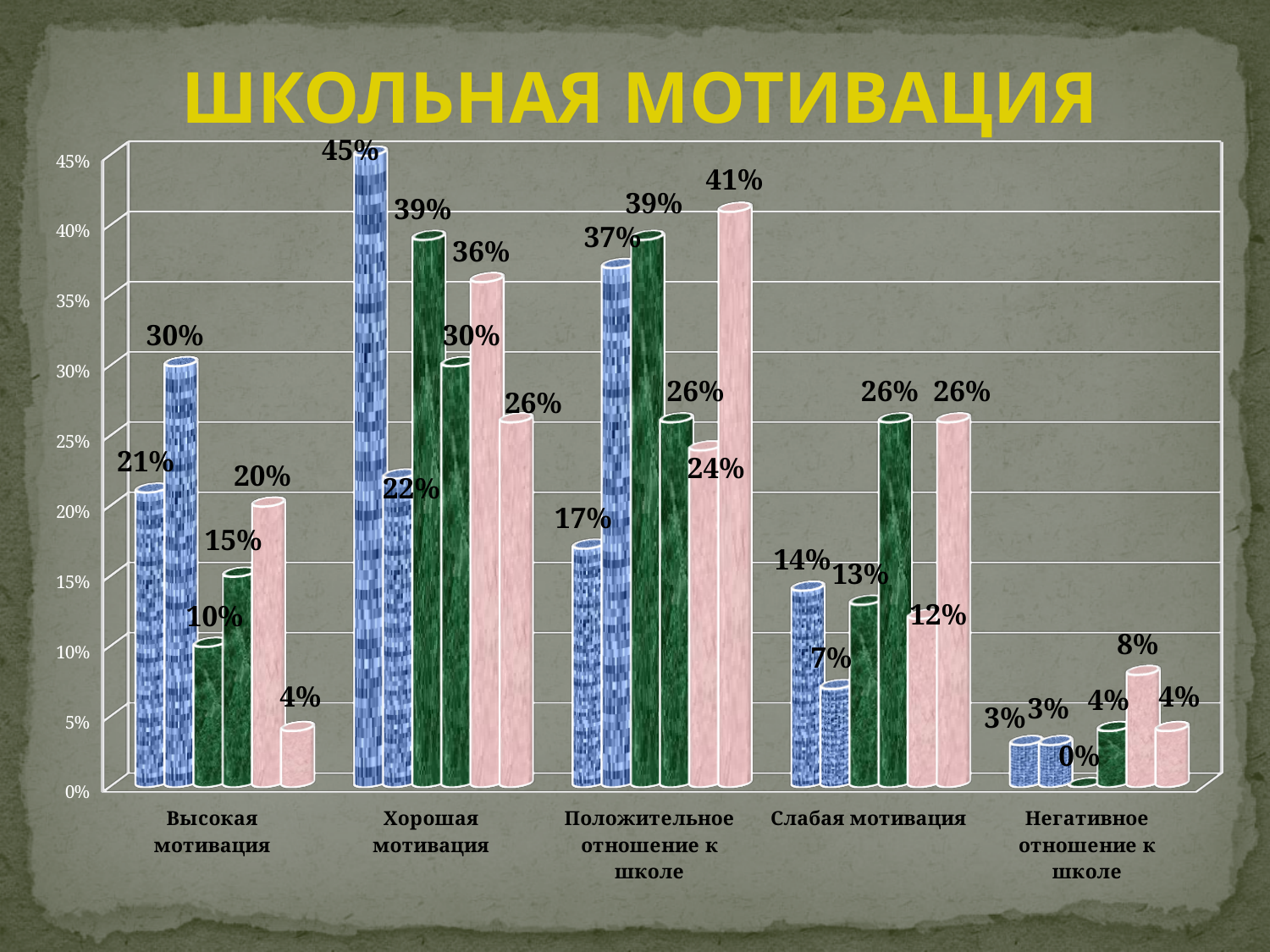
What is the highest value labelled anywhere on the chart? 45% What is the value of the tallest bar in the 'Негативное отношение к школе' group? 8% What is the difference between the tallest bar in 'Хорошая мотивация' (45%) and the tallest bar in 'Положительное отношение к школе' (41%)? 4% What is the lowest value labelled anywhere on the chart? 0% What is the title of the chart? ШКОЛЬНАЯ МОТИВАЦИЯ What is the value of the tallest bar in the 'Положительное отношение к школе' group? 41% What is the value of the tallest bar in the 'Хорошая мотивация' group? 45% What is the value of the first (leftmost) bar in the 'Высокая мотивация' group? 21% Which is larger: the last (rightmost) bar in 'Высокая мотивация' or the last bar in 'Хорошая мотивация'? the last bar in 'Хорошая мотивация' (26%) How many categories are shown along the x axis? 5 How many bars are plotted for each category? 6 What kind of chart is shown on the slide? bar chart